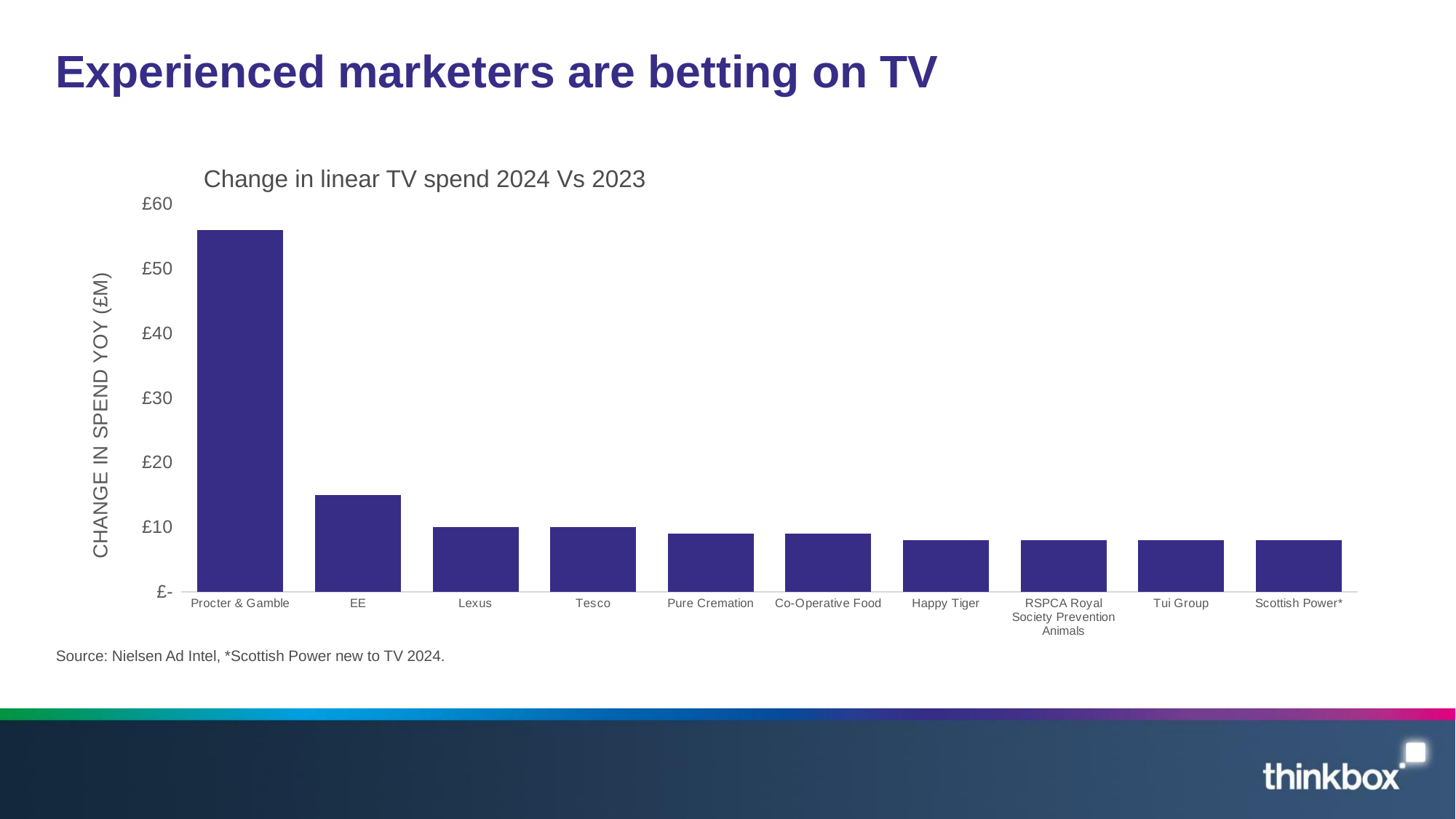
Which has a larger change in spend, EE or Lexus? EE Do the values generally rise or fall moving from left to right across the chart? fall Which advertiser has the largest change in linear TV spend? Procter & Gamble Is the value for Procter & Gamble greater or less than £50? greater Is the value for Pure Cremation greater or less than £10? less What is the title of the chart? Change in linear TV spend 2024 Vs 2023 What type of chart is shown on the slide? Bar chart What is the label on the vertical axis of the chart? CHANGE IN SPEND YOY (£M) Is the value for EE greater or less than £10? greater How many advertisers (categories) are shown in the chart? 10